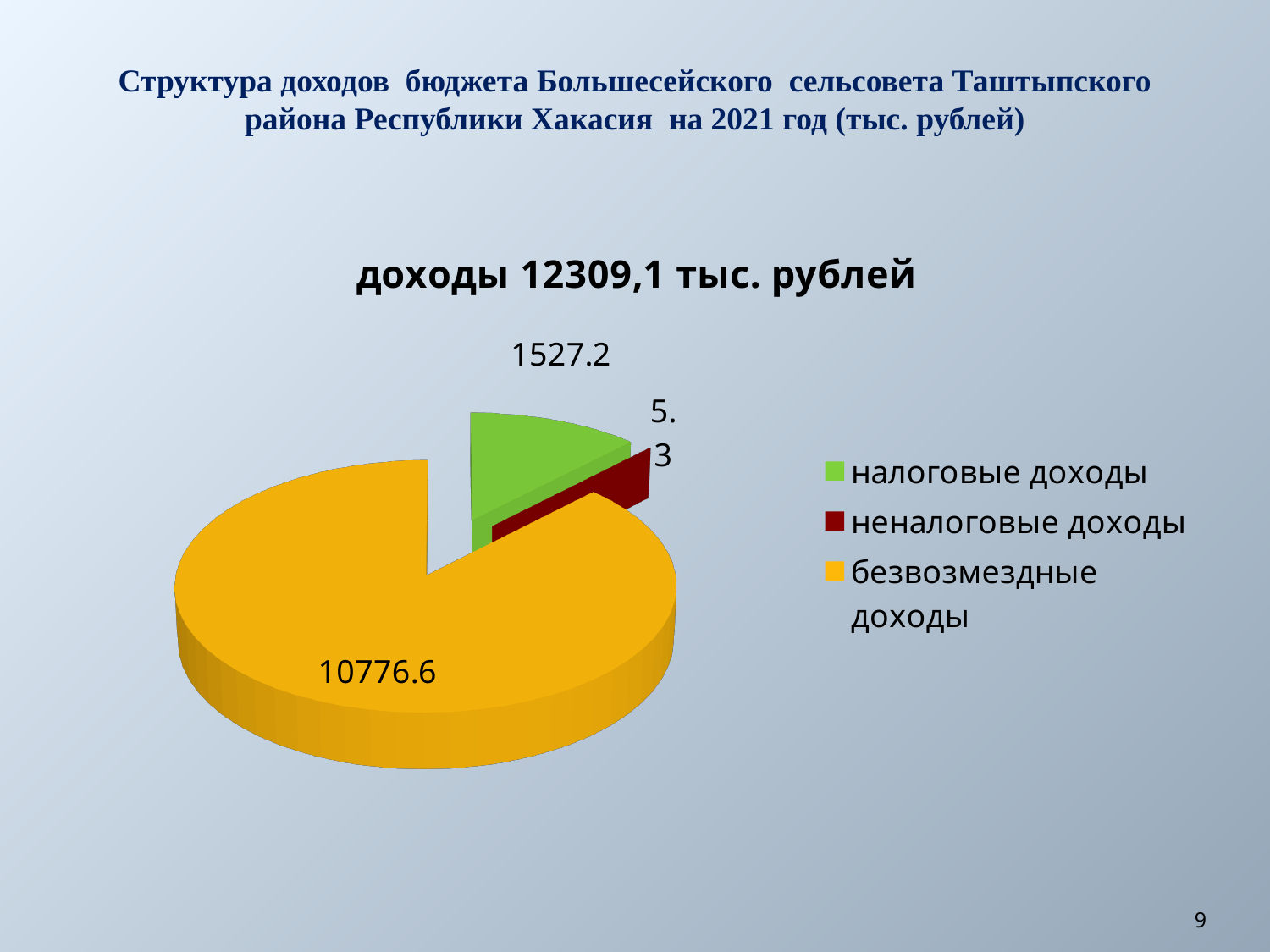
What is the difference between налоговые доходы and неналоговые доходы? 1521.9 Which is larger, налоговые доходы or неналоговые доходы? налоговые доходы What is the difference between безвозмездные доходы and налоговые доходы? 9249.4 What is the value for налоговые доходы? 1527.2 Which category has the largest slice of the pie? безвозмездные доходы Which category has the smallest slice of the pie? неналоговые доходы What colour is the slice for безвозмездные доходы? yellow What is the value for безвозмездные доходы? 10776.6 How many categories does the pie chart show? 3 What is the value for неналоговые доходы? 5.3 What is the title of the chart? доходы 12309,1 тыс. рублей What type of chart is shown on the slide? pie chart